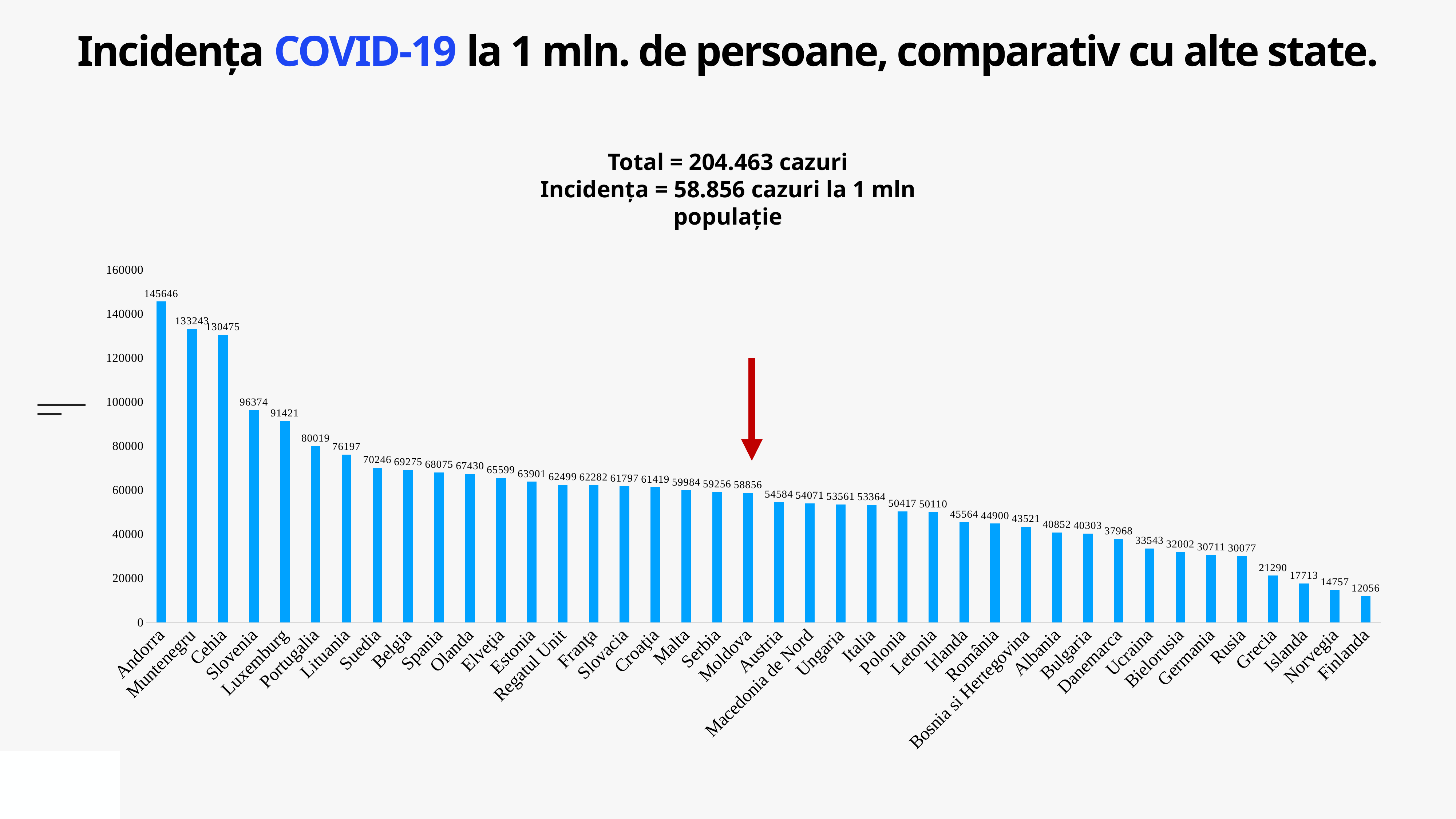
How many countries are shown on the chart? 40 Which has a larger value, Slovenia or Luxemburg? Slovenia Which country has the highest value? Andorra What kind of chart is shown on the slide? bar chart What is the value for Germania? 30711 Which country does the red arrow on the chart point to? Moldova Which country has the lowest value? Finlanda What is the value for Andorra? 145646 Is the value for Portugalia greater or less than 100000? less What is the difference between the values for Andorra and Muntenegru? 12403 Do the values rise or fall from left to right along the x axis? fall What is the value for Moldova? 58856